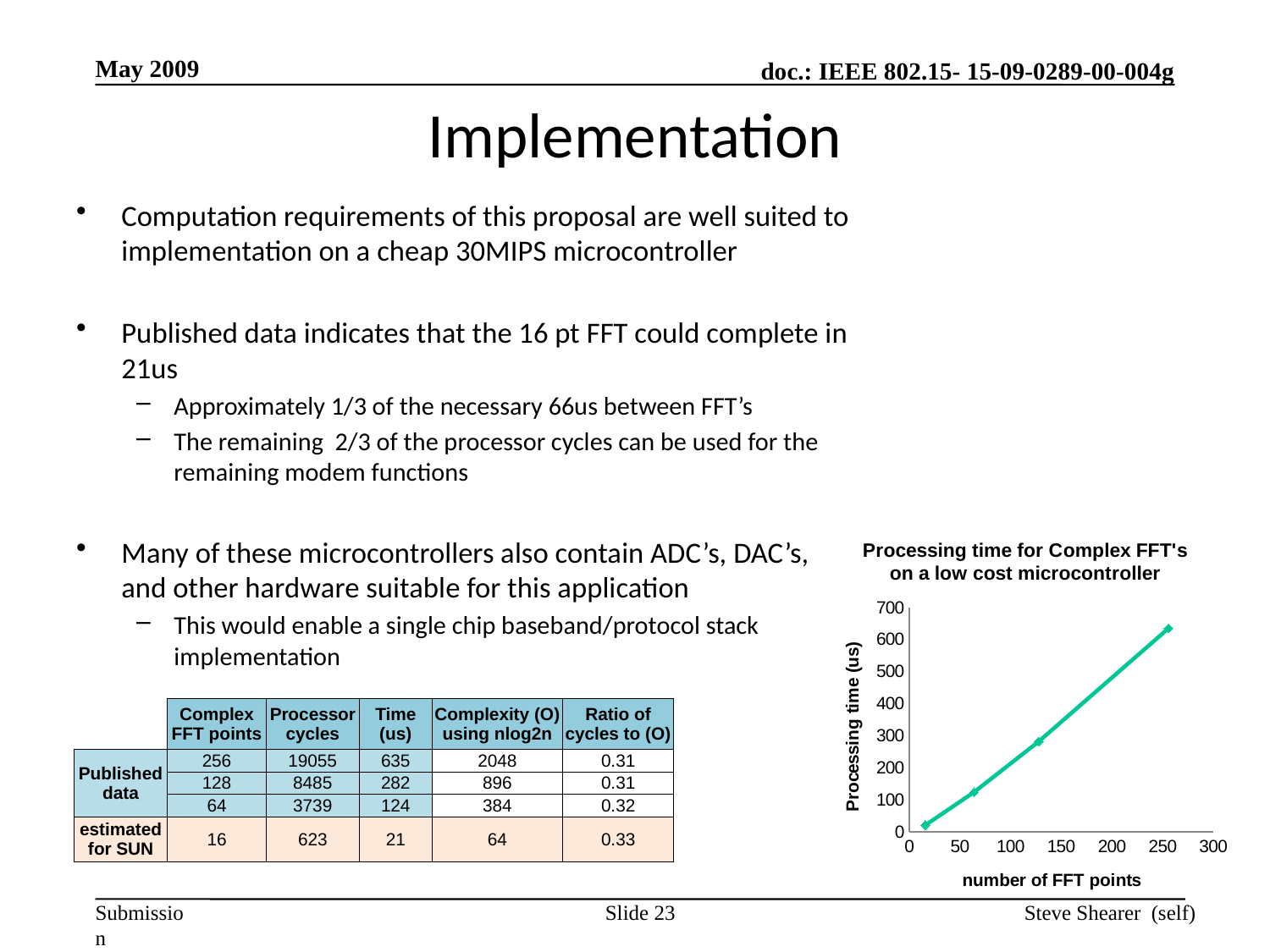
What kind of chart is shown on the slide? line chart Is the processing time for the point at about 128 FFT points greater or less than 300? less What is the title of the chart? Processing time for Complex FFT's on a low cost microcontroller Is the processing time for the rightmost point (about 256 FFT points) greater or less than 600? greater Which has the larger processing time: the point at about 128 FFT points or the point at about 64 FFT points? the point at about 128 FFT points Is the processing time for the leftmost point (about 16 FFT points) greater or less than 100? less Does processing time rise or fall as the number of FFT points increases? rises What is the label of the y axis of the chart? Processing time (us) How many data points are plotted on the chart? 4 What is the highest value shown on the y axis of the chart? 700